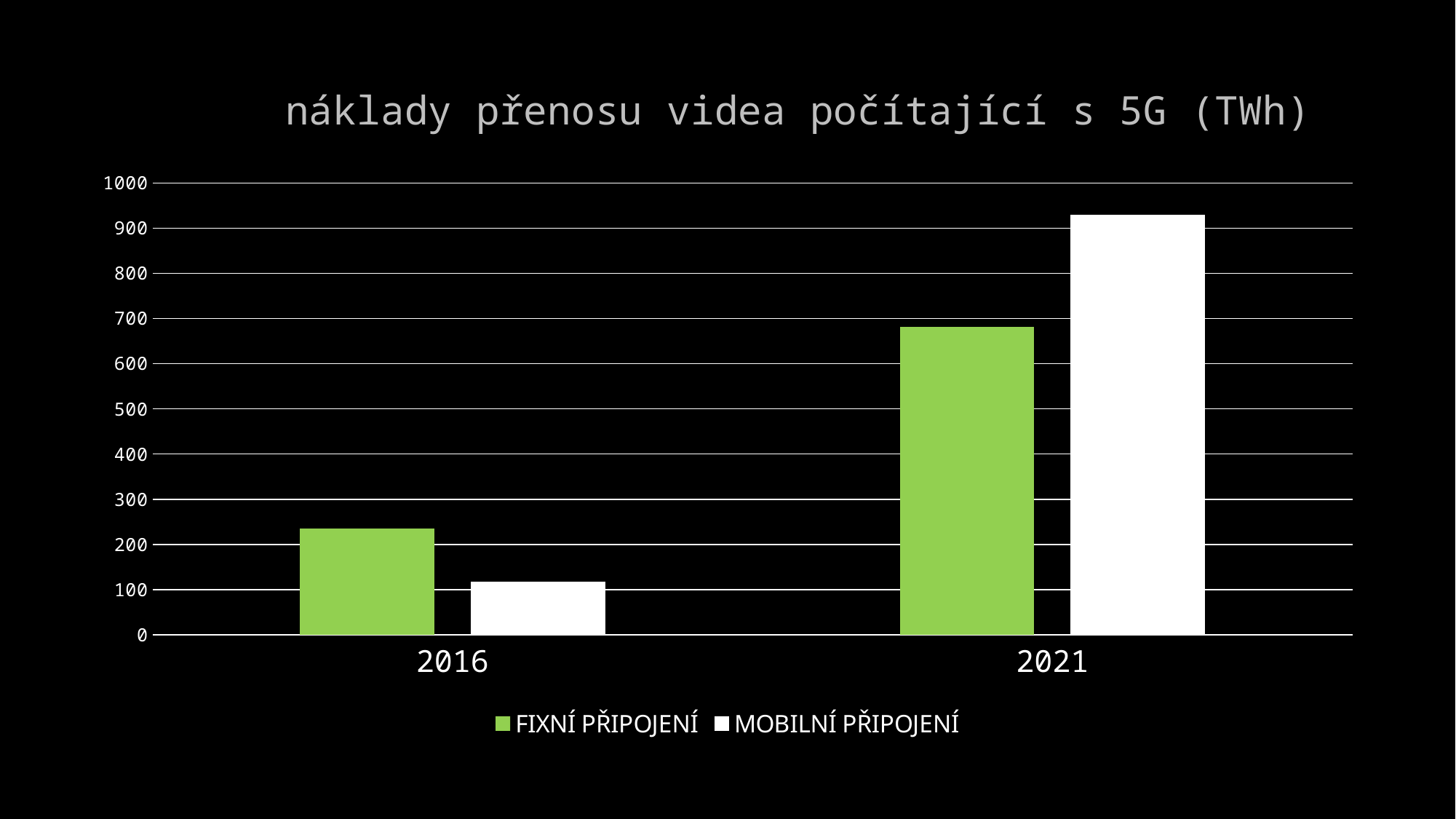
In 2021, which is larger: FIXNÍ PŘIPOJENÍ or MOBILNÍ PŘIPOJENÍ? MOBILNÍ PŘIPOJENÍ In 2016, which is larger: FIXNÍ PŘIPOJENÍ or MOBILNÍ PŘIPOJENÍ? FIXNÍ PŘIPOJENÍ What kind of chart is shown on the slide? bar chart Is the value for FIXNÍ PŘIPOJENÍ in 2016 greater or less than 200? greater Which series is shown in green? FIXNÍ PŘIPOJENÍ Which bar is the highest in the chart? MOBILNÍ PŘIPOJENÍ in 2021 How many categories are shown on the x axis? 2 Does the value for MOBILNÍ PŘIPOJENÍ rise or fall from 2016 to 2021? rise Which bar is the lowest in the chart? MOBILNÍ PŘIPOJENÍ in 2016 How many series does the legend list? 2 What is the title of the chart? náklady přenosu videa počítající s 5G (TWh) Is the value for MOBILNÍ PŘIPOJENÍ in 2021 greater or less than 800? greater